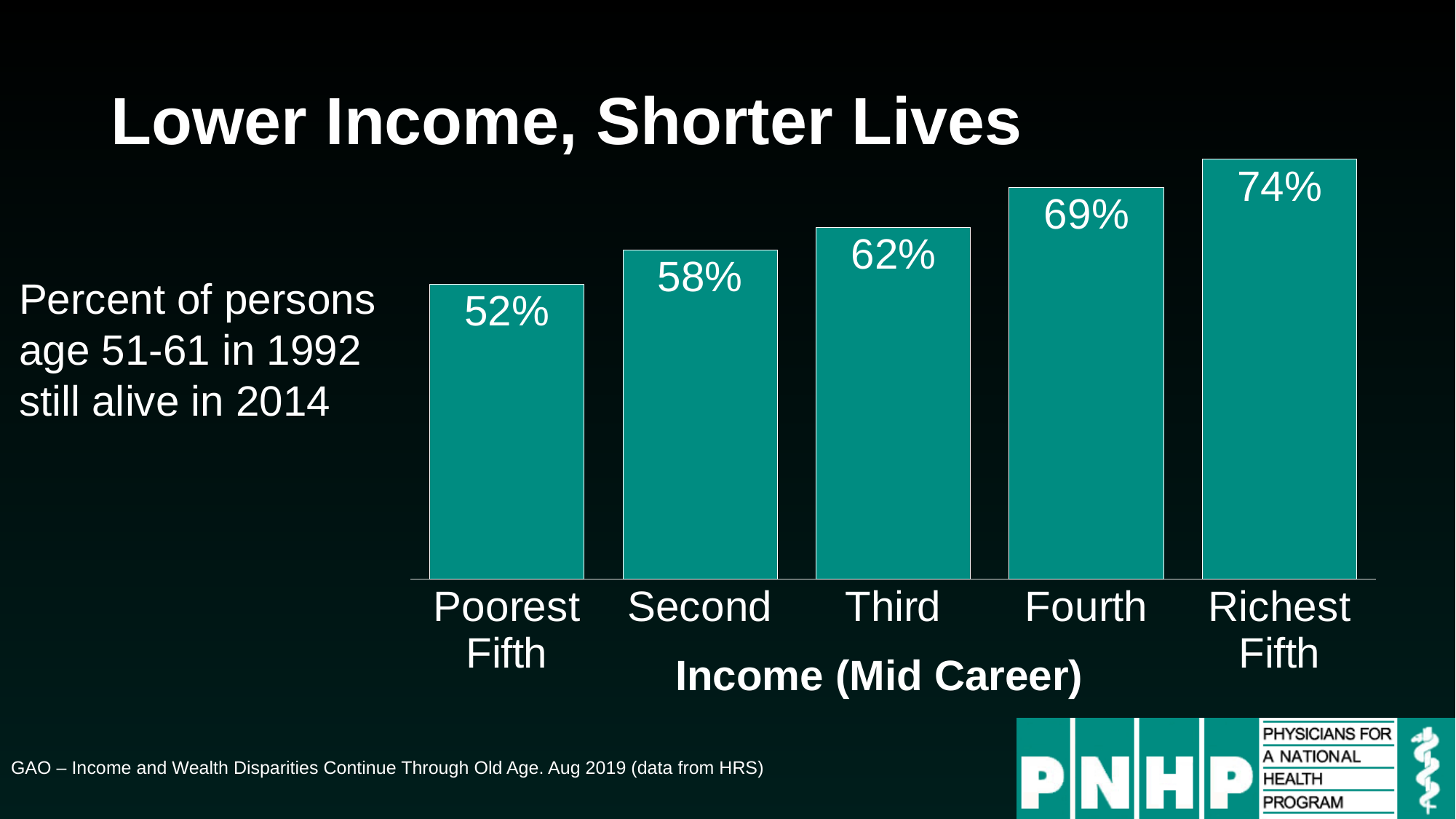
What kind of chart is shown on the slide? Bar chart What is the difference between the Second and Third income fifth values? 4% What is the value shown for the Third income fifth? 62% What is the difference between the Richest Fifth and the Poorest Fifth values? 22% What percent of persons in the Poorest Fifth were still alive in 2014? 52% Which income group has the highest percentage still alive in 2014? Richest Fifth Do the values rise or fall moving from the Poorest Fifth to the Richest Fifth? Rise What is the value shown for the Fourth income fifth? 69% What is the label of the x axis? Income (Mid Career) Which income group has the lowest percentage still alive in 2014? Poorest Fifth How many income groups are shown on the chart? 5 Which is larger, the value for Second or the value for Fourth? Fourth